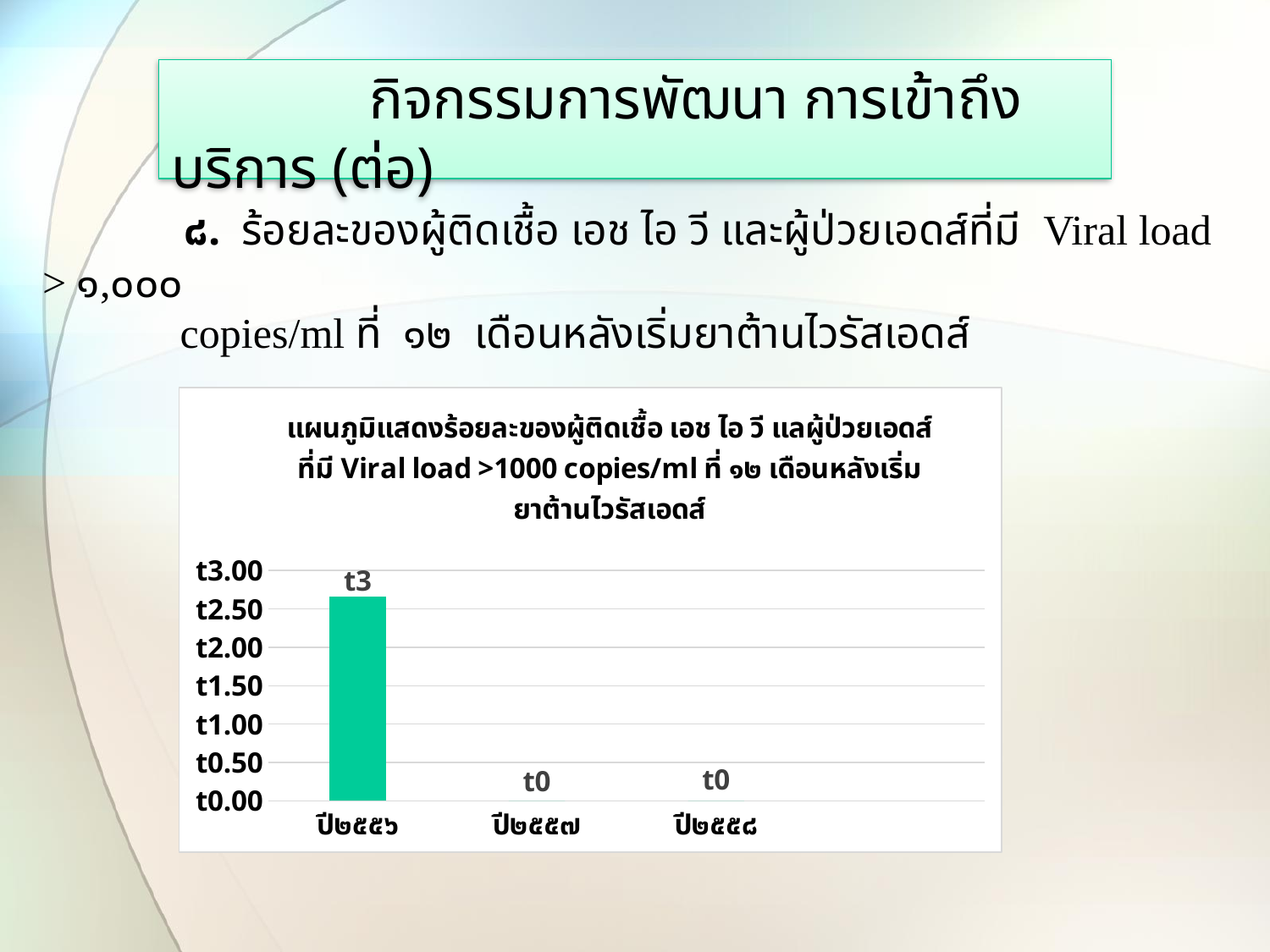
Is the bar for ปี๒๕๕๖ greater or less than t3.00 on the axis? less What is the value shown for ปี๒๕๕๖? t3 Which category has the highest value? ปี๒๕๕๖ What colour is the bar for ปี๒๕๕๖? green What kind of chart is shown on the slide? bar chart Which is larger, the value for ปี๒๕๕๖ or the value for ปี๒๕๕๗? ปี๒๕๕๖ How many categories have a value of t0? 2 What is the value shown for ปี๒๕๕๘? t0 How many categories are shown on the x axis? 3 Is the bar for ปี๒๕๕๖ greater or less than t2.50 on the axis? greater Do the values rise or fall from ปี๒๕๕๖ to ปี๒๕๕๘? fall What is the value shown for ปี๒๕๕๗? t0